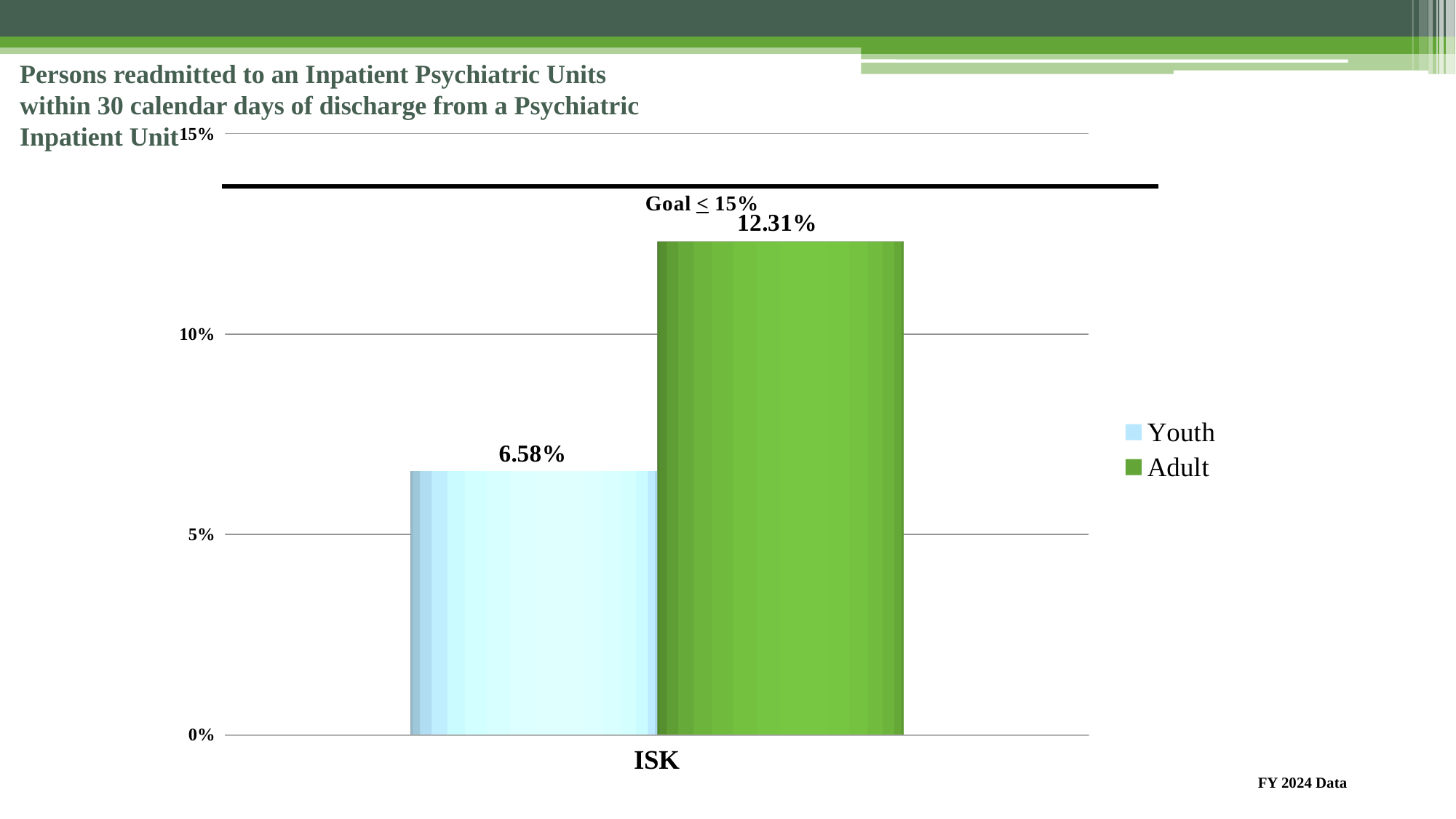
What is the difference between the Adult and Youth values for ISK? 5.73% How many categories are shown on the x axis? 1 What is the value for Adult in the ISK category? 12.31% Which series has the higher value for ISK, Youth or Adult? Adult How many series does the legend list? 2 What is the label of the category on the x axis? ISK What is the value for Youth in the ISK category? 6.58% Which series has the lowest value on the chart? Youth What goal is marked by the horizontal line on the chart? Goal ≤ 15% Is the value for Youth greater or less than 5%? greater Is the value for Adult greater or less than 10%? greater What kind of chart is shown on the slide? Bar chart